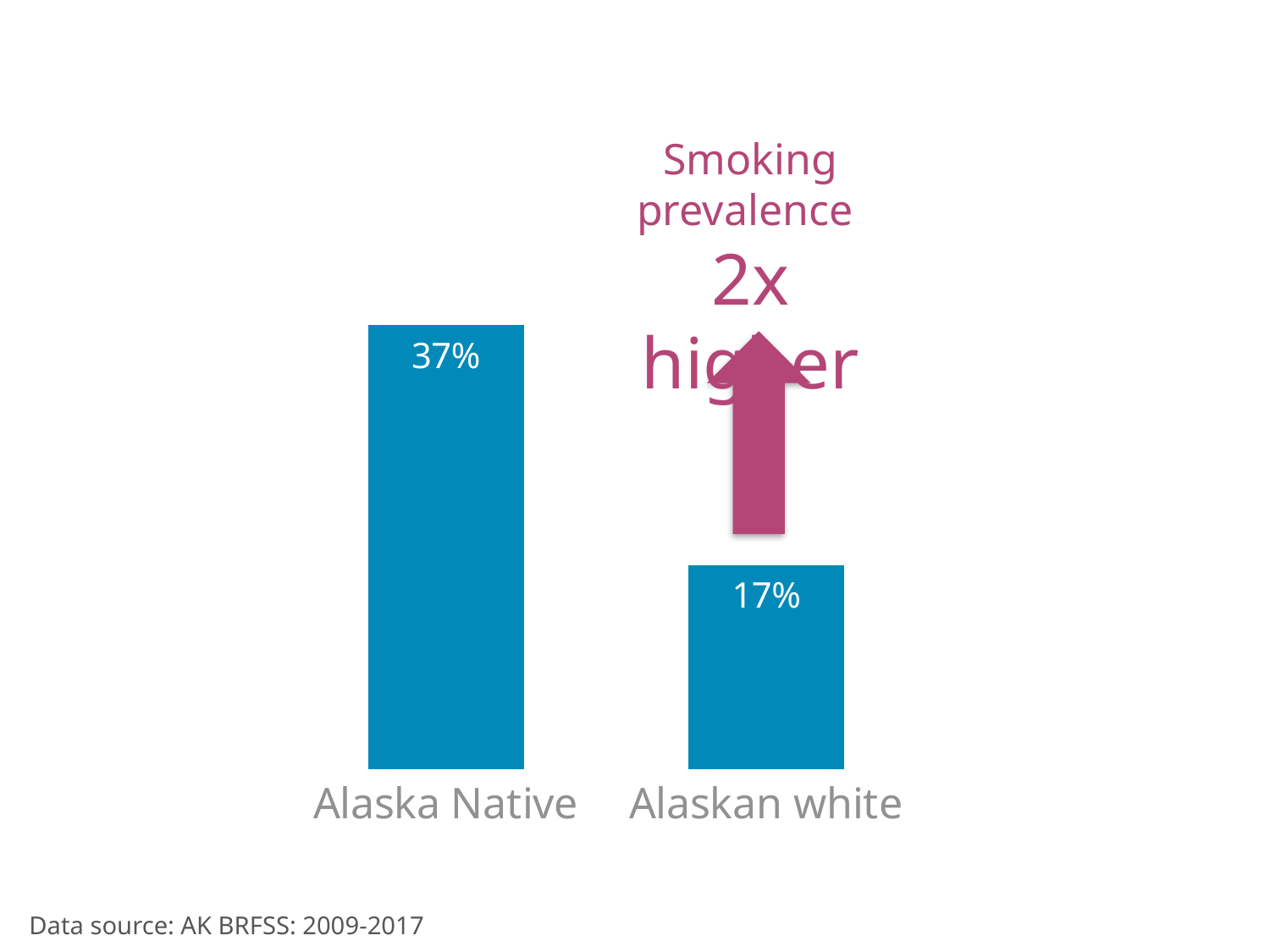
What is the smoking prevalence for Alaska Native? 37% Which is larger, the smoking prevalence for Alaska Native or for Alaskan white? Alaska Native What is the smoking prevalence for Alaskan white? 17% What kind of chart is shown on the slide? Bar chart Which category has the lowest smoking prevalence? Alaskan white How many categories are shown in the chart? 2 What is the data source cited on the slide? AK BRFSS: 2009-2017 What is the difference in smoking prevalence between Alaska Native and Alaskan white? 20% According to the annotation, how many times higher is smoking prevalence for Alaska Native compared to Alaskan white? 2x Which category has the highest smoking prevalence? Alaska Native